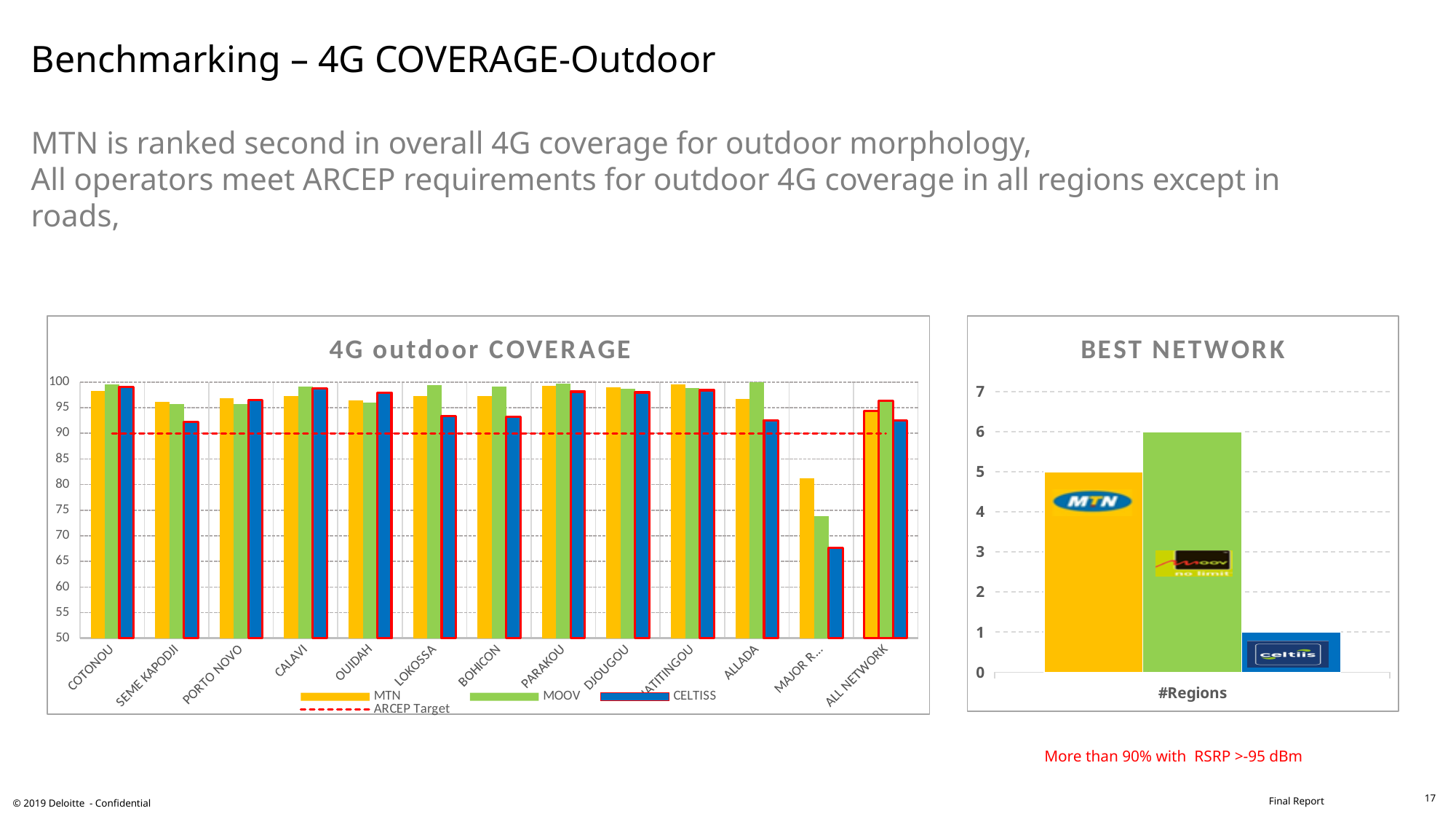
In the BEST NETWORK chart, how many regions does Celtiis win? 1 In the 4G outdoor COVERAGE chart, which is larger for ALLADA, the MOOV value or the CELTISS value? MOOV In the 4G outdoor COVERAGE chart, how many categories are shown on the x axis? 13 In the BEST NETWORK chart, how many regions does MTN win? 5 In the BEST NETWORK chart, which operator has the highest number of regions? MOOV In the 4G outdoor COVERAGE chart, is the CELTISS value for MAJOR R... greater or less than 70? less What kind of chart is the 4G outdoor COVERAGE chart? Combination bar and line chart In the BEST NETWORK chart, what is the difference in number of regions between MOOV and MTN? 1 In the BEST NETWORK chart, how many regions does MOOV win? 6 In the BEST NETWORK chart, which operator has the lowest number of regions? Celtiis In the 4G outdoor COVERAGE chart, how many entries does the legend list? 4 In the 4G outdoor COVERAGE chart, is the MOOV value for MAJOR R... greater or less than 75? less